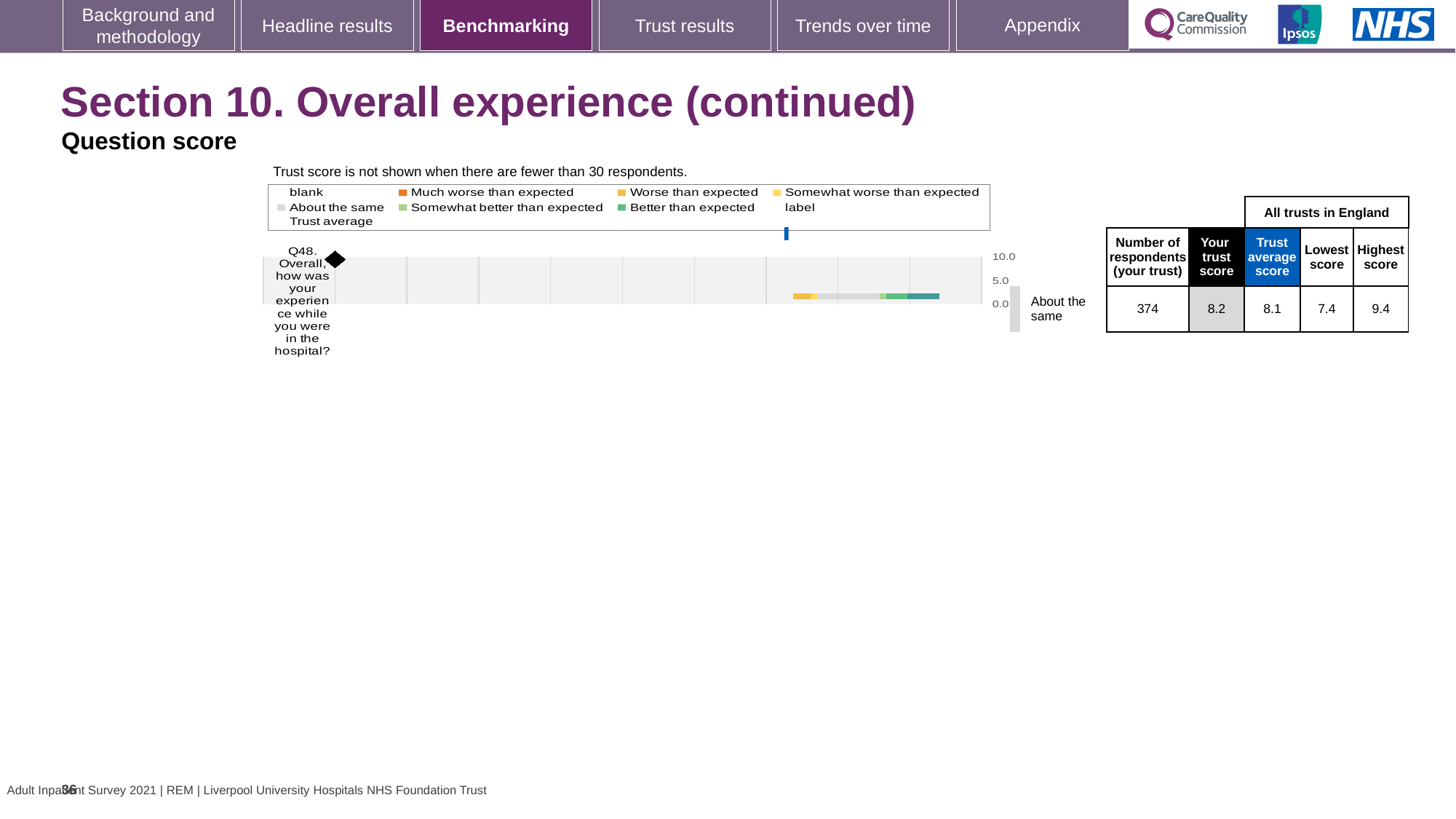
What is the difference between the highest and lowest scores for Q48 across all trusts in England? 2.0 How many survey questions are plotted in the chart on this slide? 1 What kind of chart is used to show the Q48 benchmarking result? Bar chart Which is larger for Q48: your trust score or the trust average score? Your trust score What is the highest score among all trusts in England for Q48? 9.4 What is the trust average score for Q48 across all trusts in England? 8.1 What is the lowest score among all trusts in England for Q48? 7.4 Which survey question is plotted in the benchmarking chart? Q48. Overall, how was your experience while you were in the hospital? By how much does your trust score for Q48 exceed the trust average score? 0.1 What is the 'Your trust score' for Q48? 8.2 Which benchmark category is the trust's Q48 score placed in? About the same How many respondents from your trust answered Q48? 374